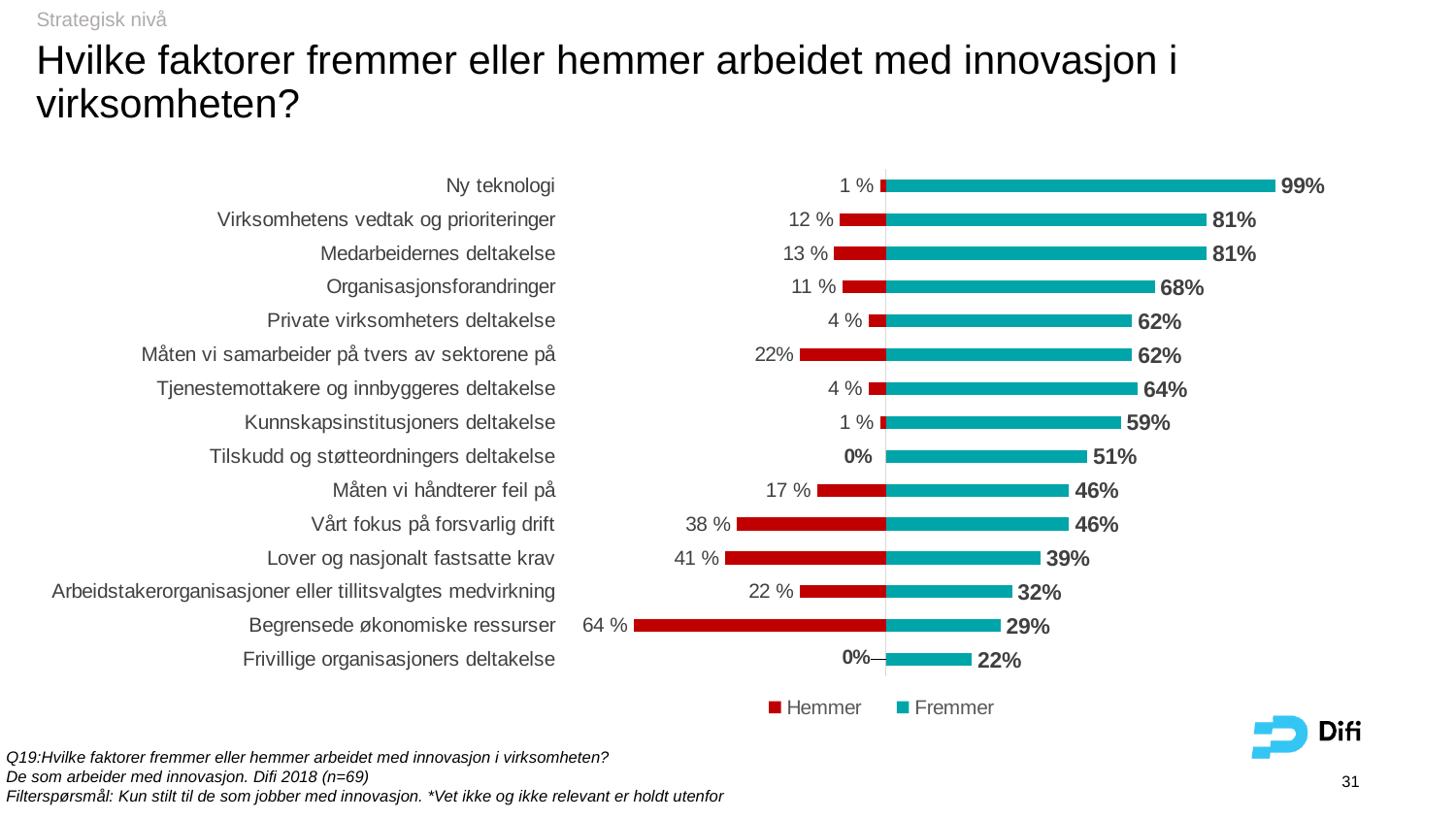
Which category has the highest Hemmer value? Begrensede økonomiske ressurser What is the difference between the Fremmer and Hemmer values for Begrensede økonomiske ressurser? 35 percentage points How many categories are shown in the chart? 15 Which is larger for Lover og nasjonalt fastsatte krav, the Hemmer value or the Fremmer value? Hemmer What is the Hemmer value for Begrensede økonomiske ressurser? 64 % What is the Hemmer value for Vårt fokus på forsvarlig drift? 38 % Which category has the lowest Fremmer value? Frivillige organisasjoners deltakelse How many series does the legend list? 2 What kind of chart is shown on the slide? Bar chart Which category has the highest Fremmer value? Ny teknologi What is the Fremmer value for Lover og nasjonalt fastsatte krav? 39% What is the Fremmer value for Ny teknologi? 99%